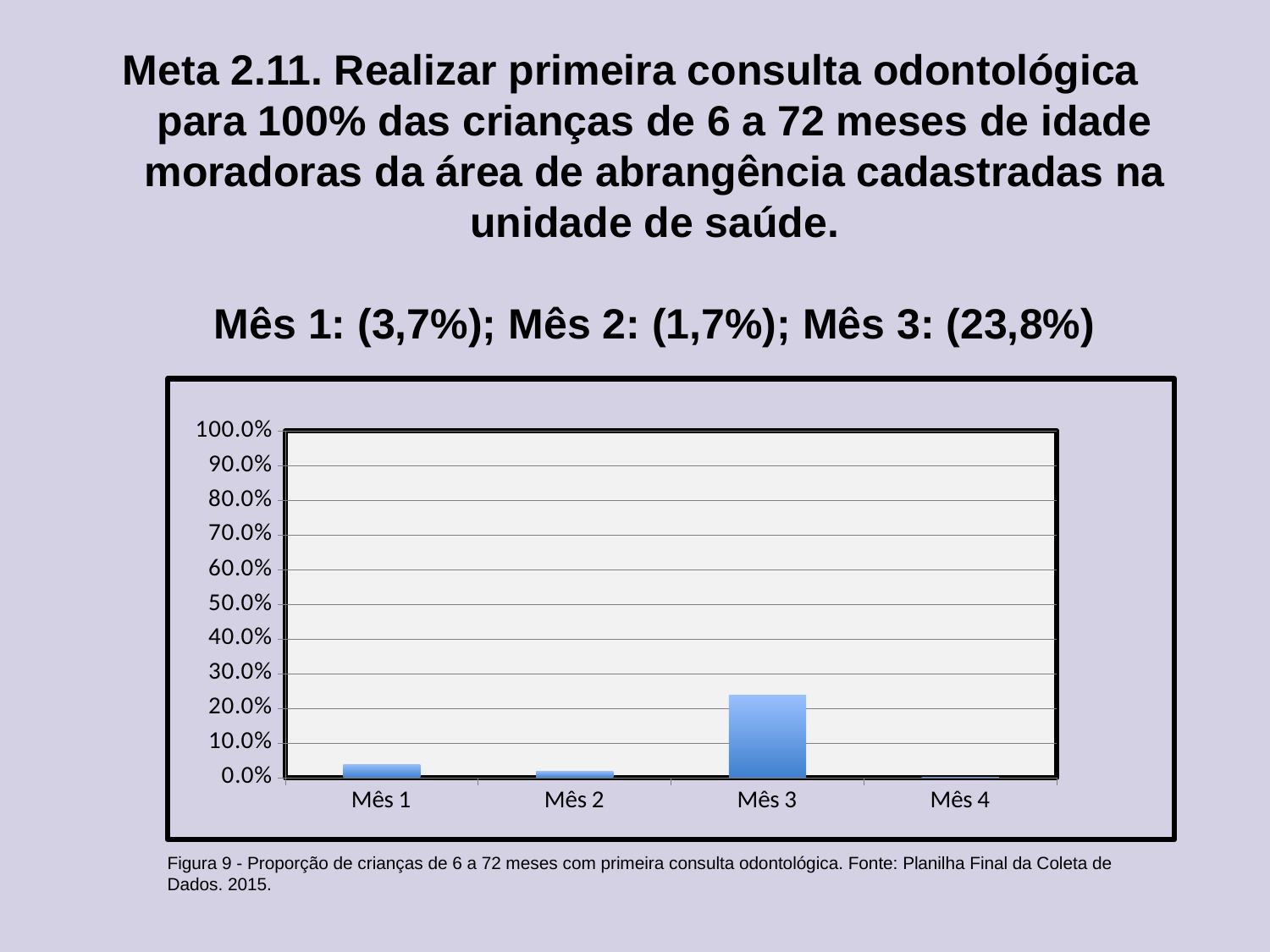
Is the value for Mês 3 greater or less than 20.0%? greater What is the value for Mês 2? 1,7% What is the value for Mês 1? 3,7% How many categories (months) are shown on the x axis of the chart? 4 Is the value for Mês 3 greater or less than 30.0%? less What is the highest tick value shown on the y axis of the chart? 100.0% What is the value for Mês 3? 23,8% Which is larger, the value for Mês 1 or the value for Mês 2? Mês 1 Which month has the highest bar in the chart? Mês 3 What is the difference between the values for Mês 1 and Mês 2? 2,0% What kind of chart is shown on the slide? bar chart What is the difference between the values for Mês 3 and Mês 1? 20,1%